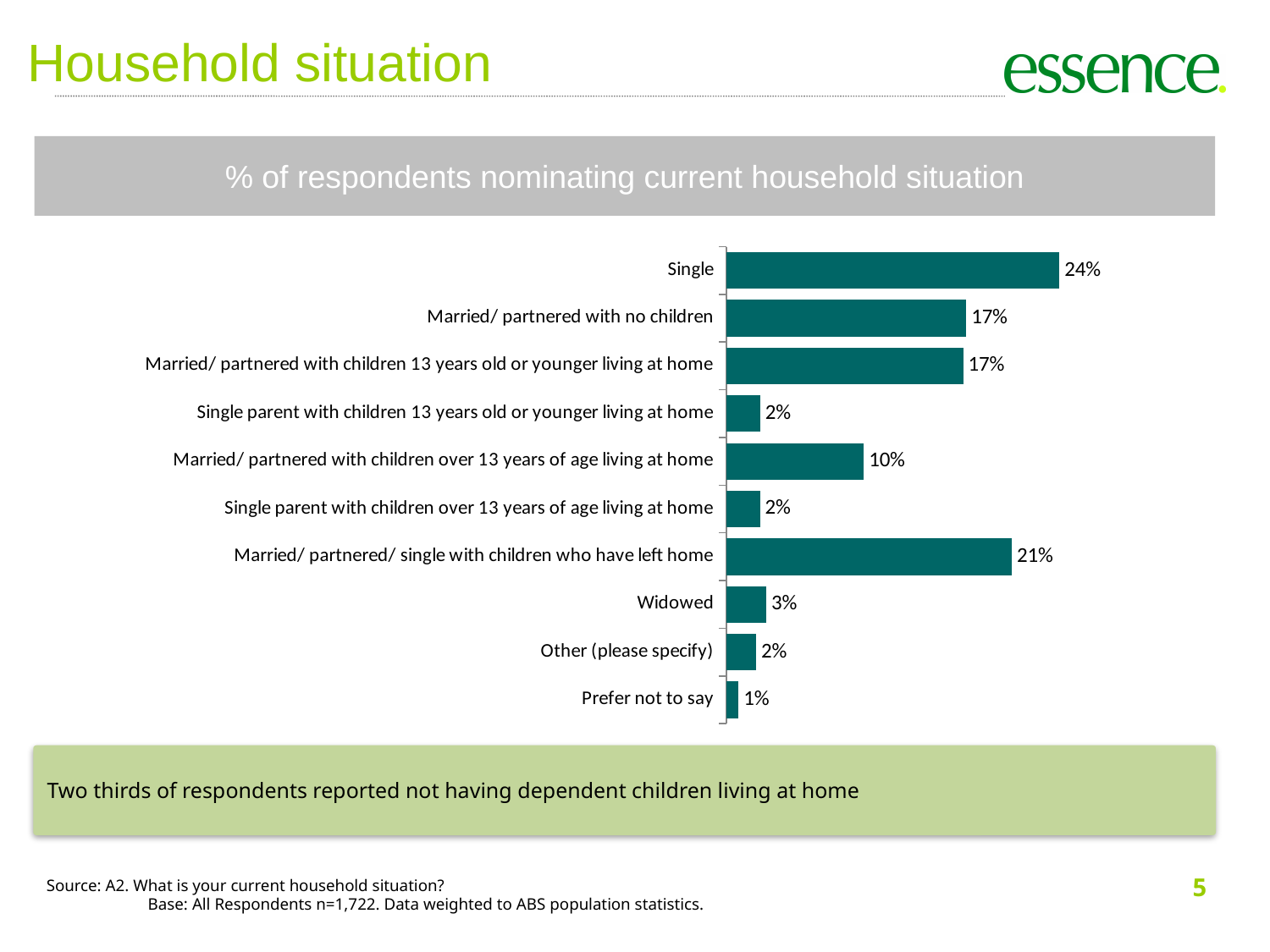
What is the difference in percentage points between Married/ partnered with no children and Single parent with children 13 years old or younger living at home? 15% What is the title of the chart? % of respondents nominating current household situation What percentage of respondents are Widowed? 3% Which household situation has the highest percentage of respondents? Single Which is larger: the percentage for Married/ partnered/ single with children who have left home or for Married/ partnered with no children? Married/ partnered/ single with children who have left home What percentage of respondents chose Prefer not to say? 1% What percentage of respondents are Married/ partnered with children over 13 years of age living at home? 10% What percentage of respondents are Single? 24% What is the difference in percentage points between Single and Married/ partnered/ single with children who have left home? 3% What type of chart is used on this slide? Bar chart How many household situation categories are shown in the chart? 10 Which household situation has the lowest percentage of respondents? Prefer not to say